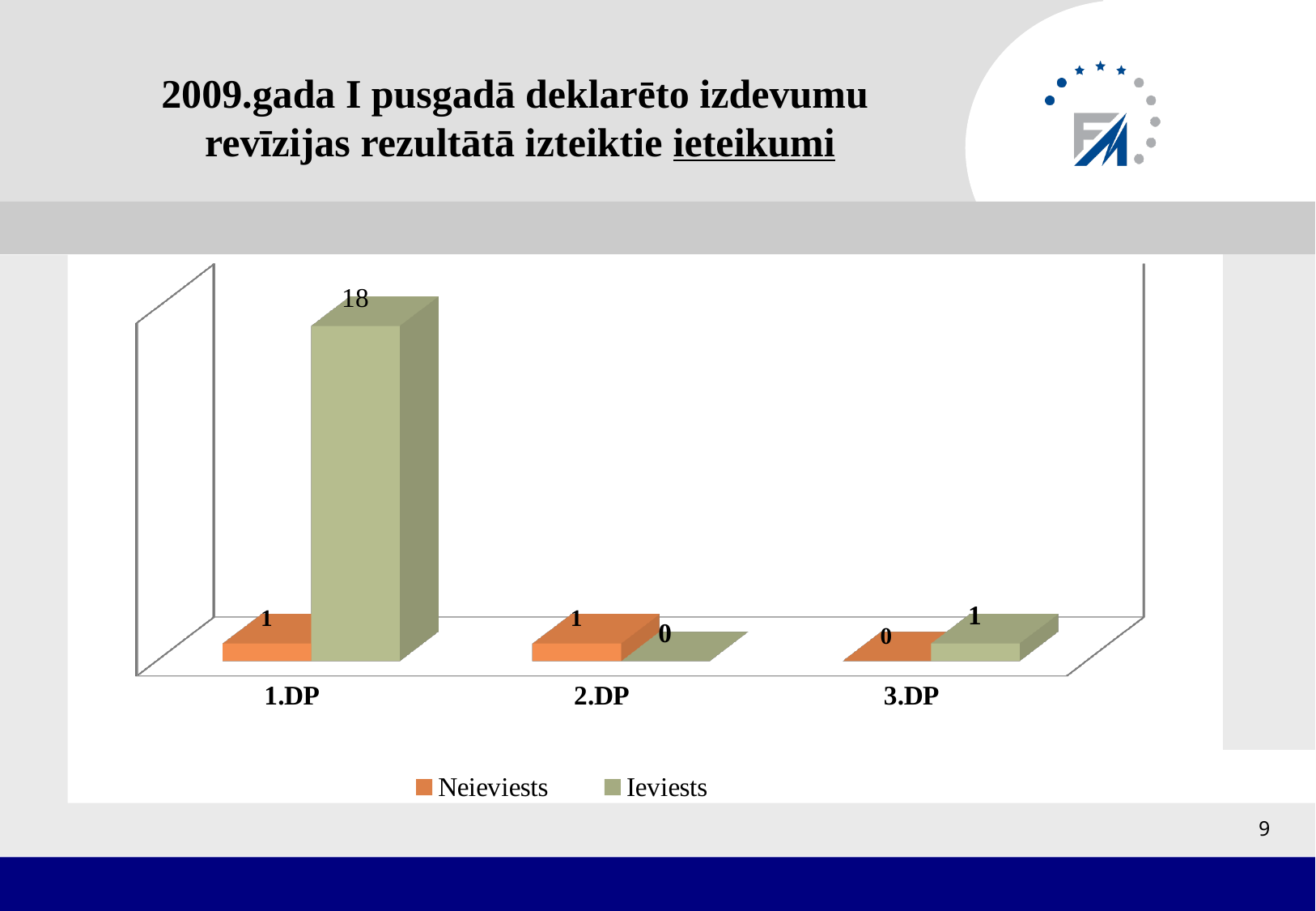
What is the difference between the Ieviests and Neieviests values for 1.DP? 17 What kind of chart is shown on the slide? Bar chart What is the value of Neieviests for 3.DP? 0 How many series does the legend list? 2 Which category has the highest Ieviests value? 1.DP What is the value of Ieviests for 2.DP? 0 Which category has the lowest Ieviests value? 2.DP For 2.DP, which is larger: Neieviests or Ieviests? Neieviests How many categories are shown on the x axis? 3 What is the value of Ieviests for 3.DP? 1 What is the value of Neieviests for 1.DP? 1 What is the value of Ieviests for 1.DP? 18